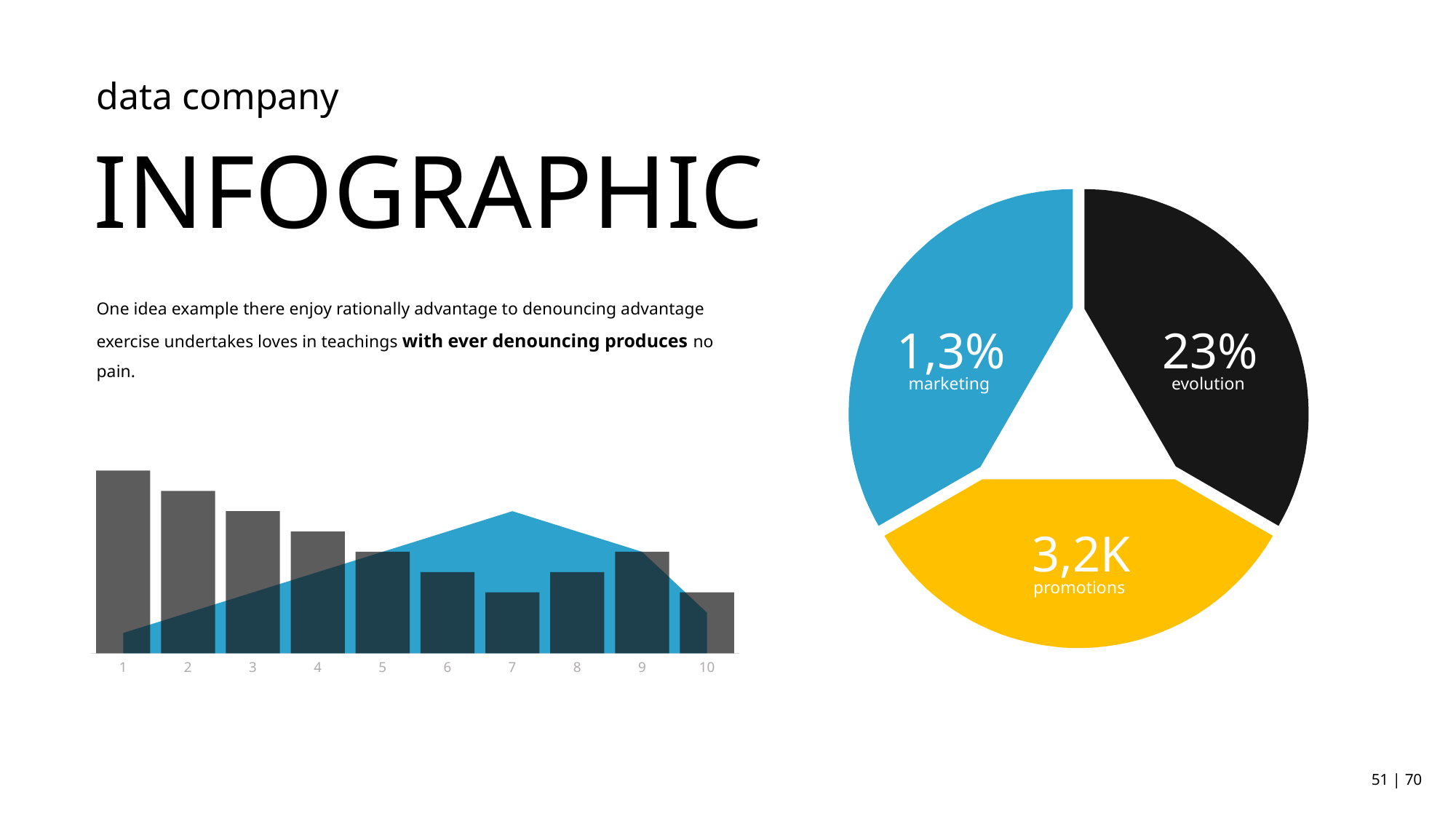
In the bar chart on the left, is the bar for category 1 taller or shorter than the bar for category 10? taller In the pie chart on the right, what value is printed on the marketing slice? 1,3% In the pie chart on the right, what value is printed on the evolution slice? 23% What type of chart is shown on the right side of the slide? pie chart In the bar chart on the left, do the bars rise or fall from category 1 to category 4? fall In the pie chart on the right, which slice is coloured yellow? promotions In the bar chart on the left, which category has the shortest bar? 7 and 10 (tied) What type of chart is shown on the left side of the slide? combination bar and area chart In the bar chart on the left, at which category does the blue shaded area reach its peak? 7 In the bar chart on the left, is the bar for category 9 taller or shorter than the bar for category 6? taller In the bar chart on the left, how many categories are shown on the x axis? 10 In the bar chart on the left, which category has the tallest bar? 1